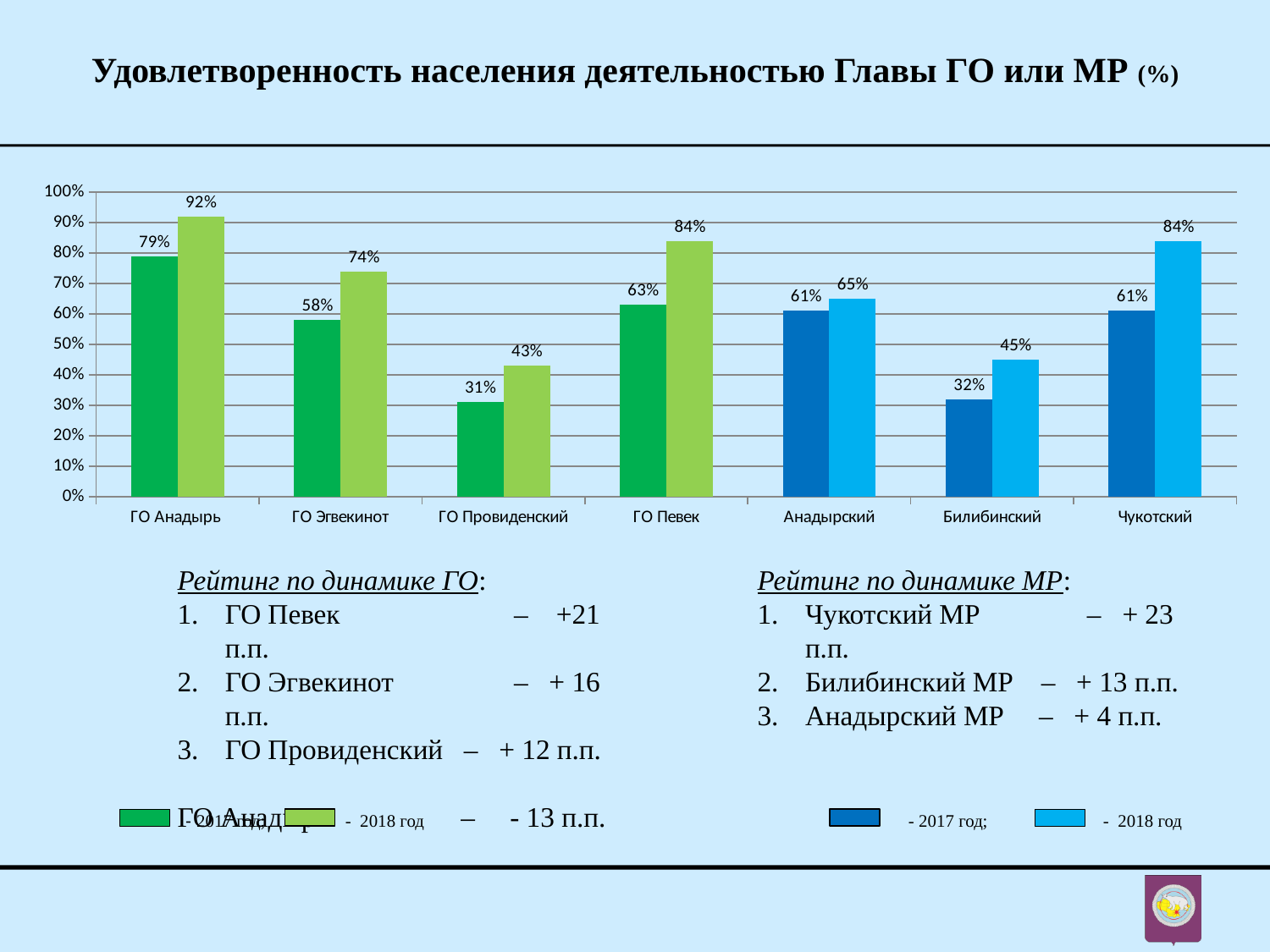
Which category has the highest bar on the chart? ГО Анадырь (92%) What is the value of the right-hand (light green) bar for ГО Певек? 84% What colour are the bars for the ГО categories compared with the МР categories? ГО bars are green, МР bars are blue What is the value of the right-hand (light blue) bar for Анадырский? 65% Which is larger: the left-hand bar for Анадырский or the left-hand bar for Билибинский? Анадырский (61%) What is the value of the left-hand (dark green) bar for ГО Провиденский? 31% Which category has the lowest bar on the chart? ГО Провиденский (31%) What is the difference between the two bars for Чукотский (84% and 61%)? 23 percentage points What is the difference between the two bars for ГО Анадырь (92% and 79%)? 13 percentage points What type of chart is shown on the slide? Bar chart How many categories are shown on the x axis of the chart? 7 What is the value of the left-hand (dark blue) bar for Чукотский? 61%